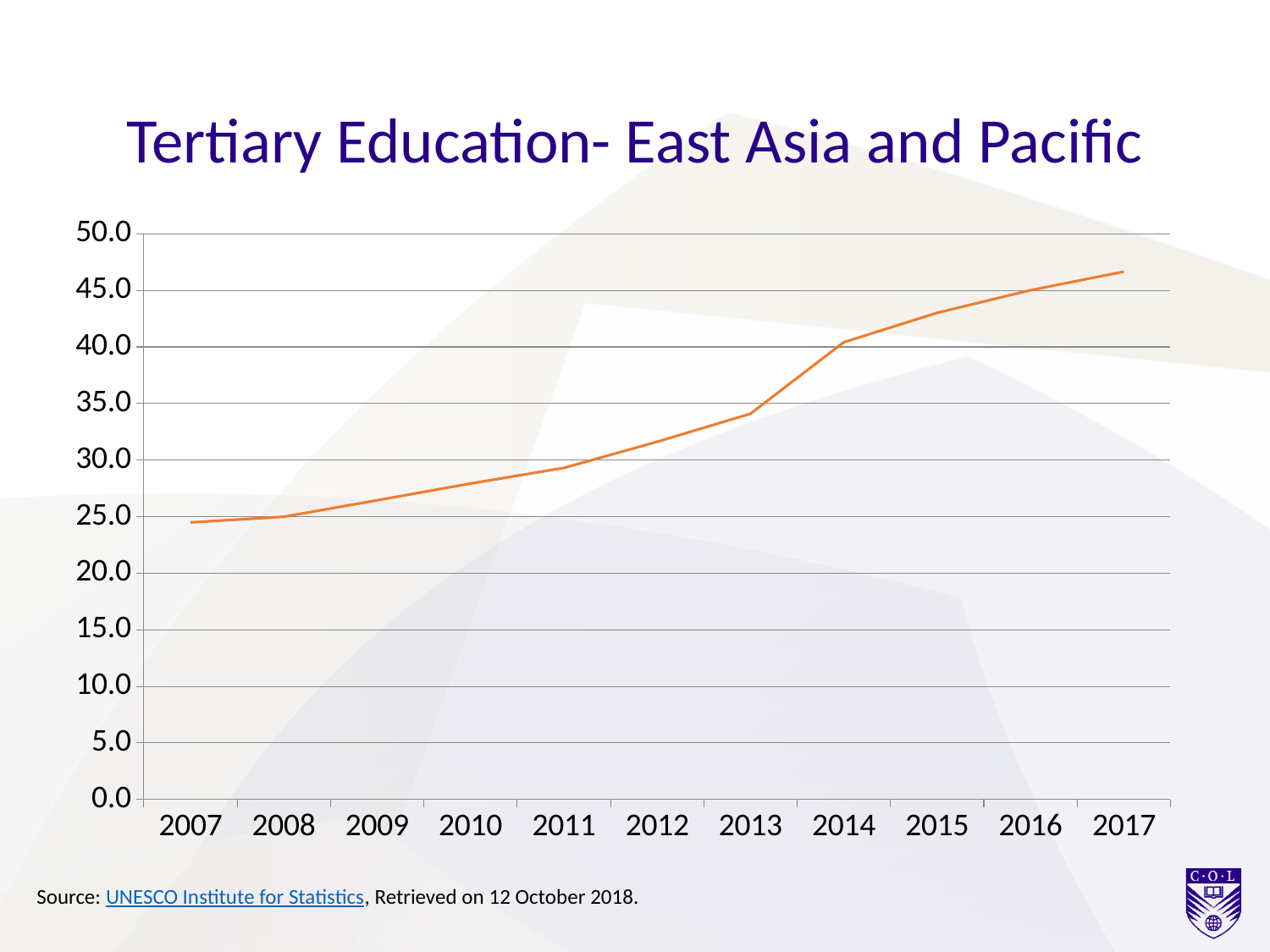
Is the value for 2016 greater or less than 40.0? greater What kind of chart is shown on the slide? line chart Which year has the highest value? 2017 Is the value for 2007 greater or less than 30.0? less Do the values generally rise or fall from 2007 to 2017? rise What is the highest value shown on the y axis? 50.0 Is the value for 2017 greater or less than 45.0? greater What is the title of the chart? Tertiary Education- East Asia and Pacific How many years are plotted along the x axis? 11 Which is larger, the value for 2013 or the value for 2014? 2014